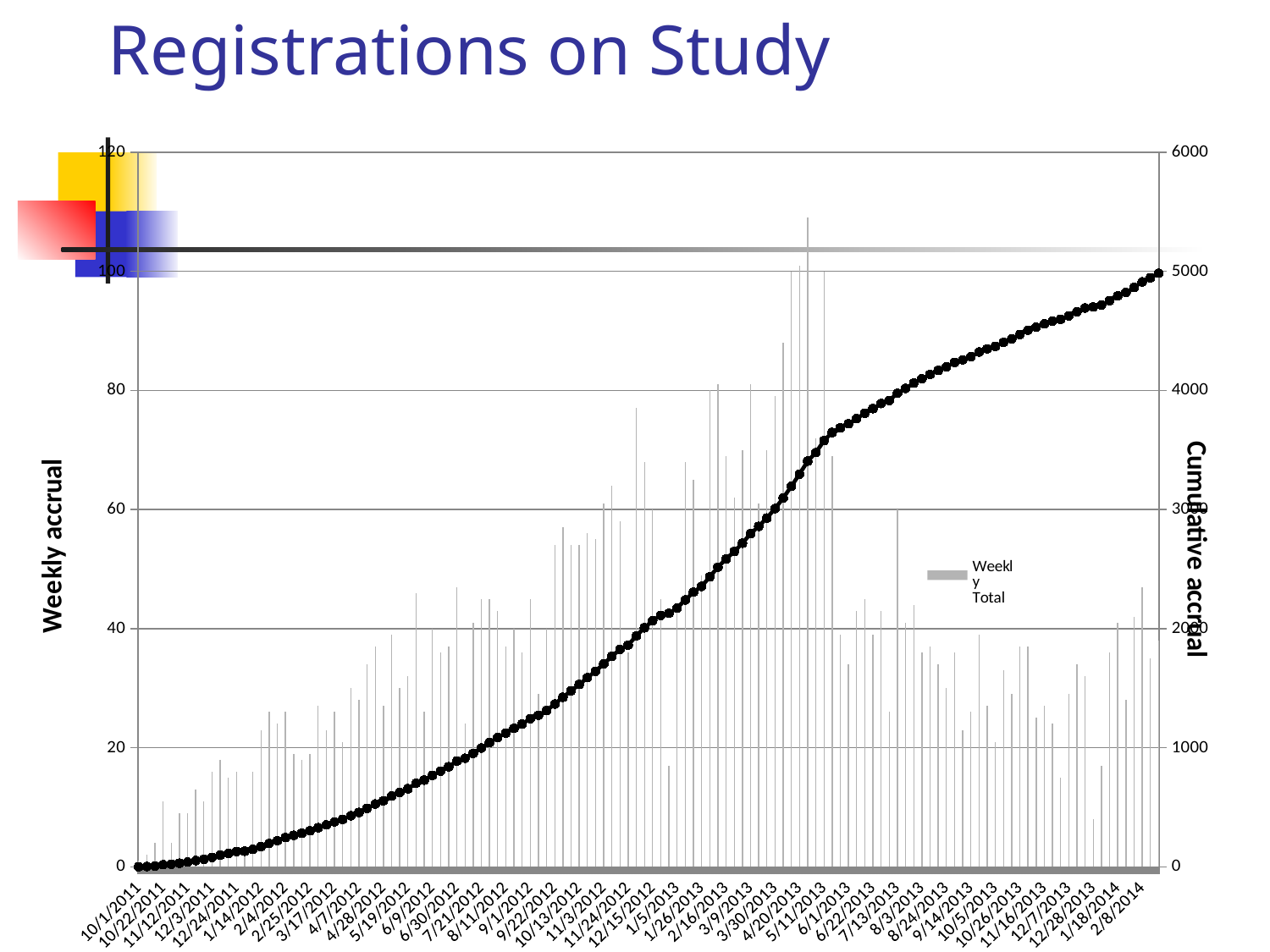
Is the tallest weekly accrual bar greater or less than 100? greater Is the cumulative accrual on 9/22/2012 greater or less than 1000? greater Which is larger, the cumulative accrual on 2/8/2014 or on 10/1/2011? 2/8/2014 Is the cumulative accrual on 4/7/2012 greater or less than 1000? less What is the title of the chart? Registrations on Study What is the label of the left vertical axis? Weekly accrual What is the highest value shown on the right (Cumulative accrual) axis? 6000 Does the cumulative accrual (Total) line rise or fall from 10/1/2011 to 2/8/2014? Rises How many series does the legend list? 2 What kind of chart is shown on the slide? A combined bar and line chart